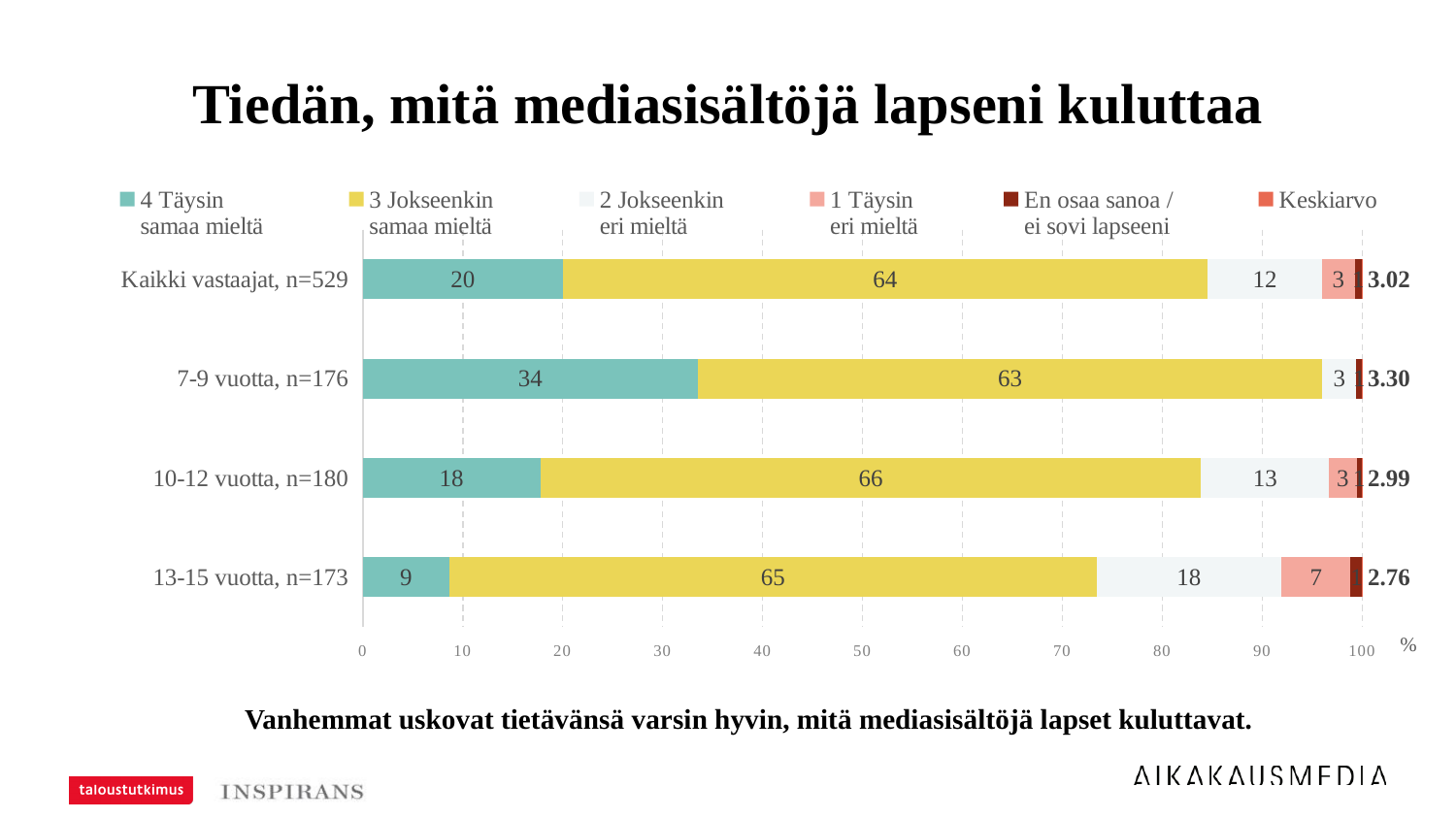
What is the title of the chart? Tiedän, mitä mediasisältöjä lapseni kuluttaa Which is larger: the "2 Jokseenkin eri mieltä" value for "13-15 vuotta, n=173" or for "10-12 vuotta, n=180"? 13-15 vuotta, n=173 What is the value of "4 Täysin samaa mieltä" for "7-9 vuotta, n=176"? 34 What is the Keskiarvo value for "13-15 vuotta, n=173"? 2.76 How many categories (bars) are shown in the chart? 4 What is the value of "3 Jokseenkin samaa mieltä" for "10-12 vuotta, n=180"? 66 Which category has the lowest Keskiarvo value? 13-15 vuotta, n=173 What type of chart is shown on the slide? stacked bar chart What is the difference between the "4 Täysin samaa mieltä" values for "7-9 vuotta, n=176" and "13-15 vuotta, n=173"? 25 What is the value of "2 Jokseenkin eri mieltä" for "Kaikki vastaajat, n=529"? 12 Which category has the highest value for "4 Täysin samaa mieltä"? 7-9 vuotta, n=176 How many series does the legend list? 6